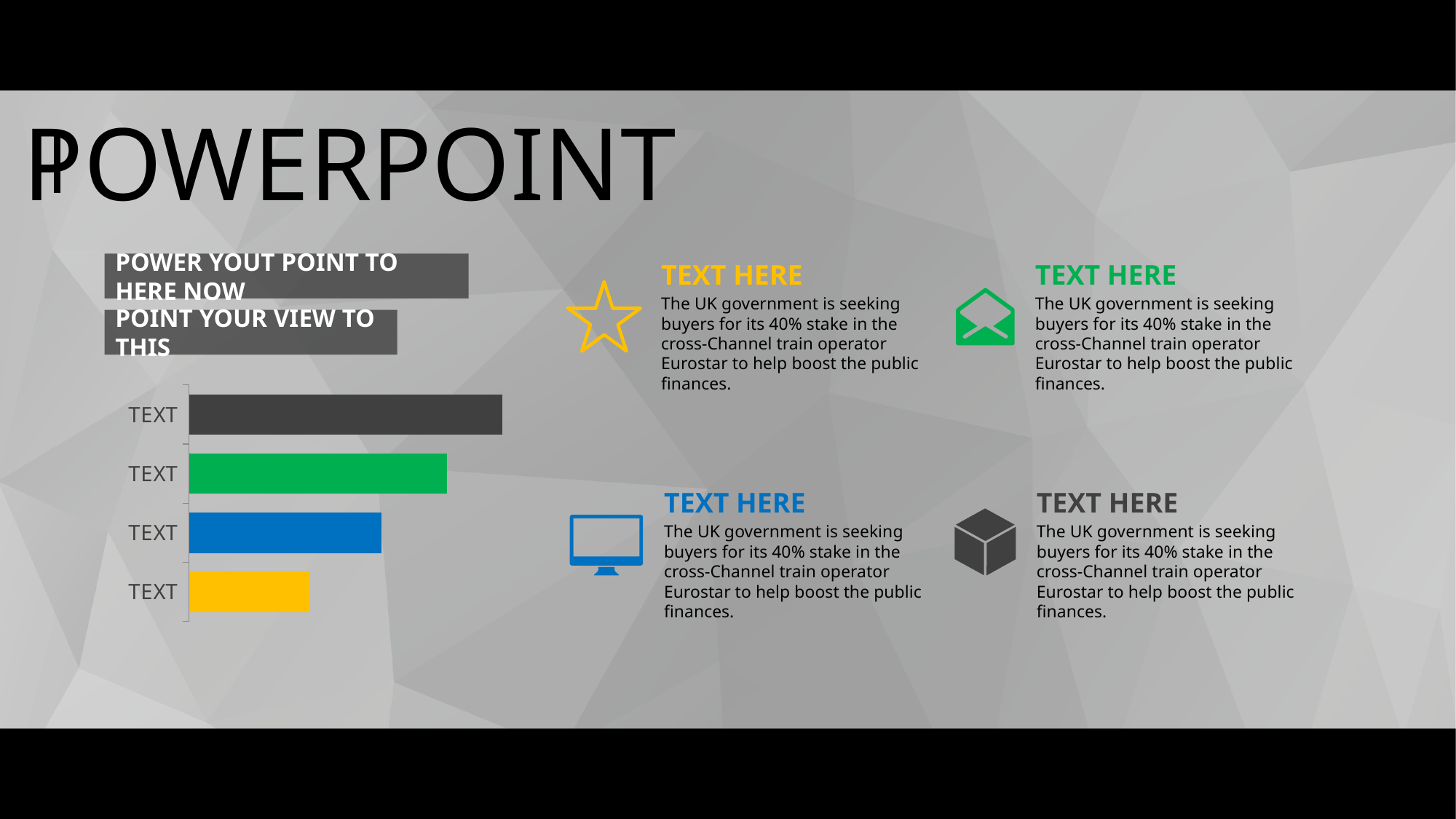
In the bar chart, is the green bar longer or shorter than the blue bar? longer What label is shown for each category on the vertical axis of the bar chart? TEXT In the bar chart, is the blue bar longer or shorter than the yellow bar? longer In the bar chart, is the yellow bar longer or shorter than the dark grey bar? shorter How many bars does the bar chart on the left of the slide have? 4 Which bar in the bar chart is the shortest: the dark grey, green, blue or yellow one? yellow What colour is the top bar in the bar chart? dark grey Do the bars in the bar chart get longer or shorter going from the top bar to the bottom bar? shorter Which bar in the bar chart is the longest: the dark grey, green, blue or yellow one? dark grey What kind of chart is shown on the left of the slide? bar chart